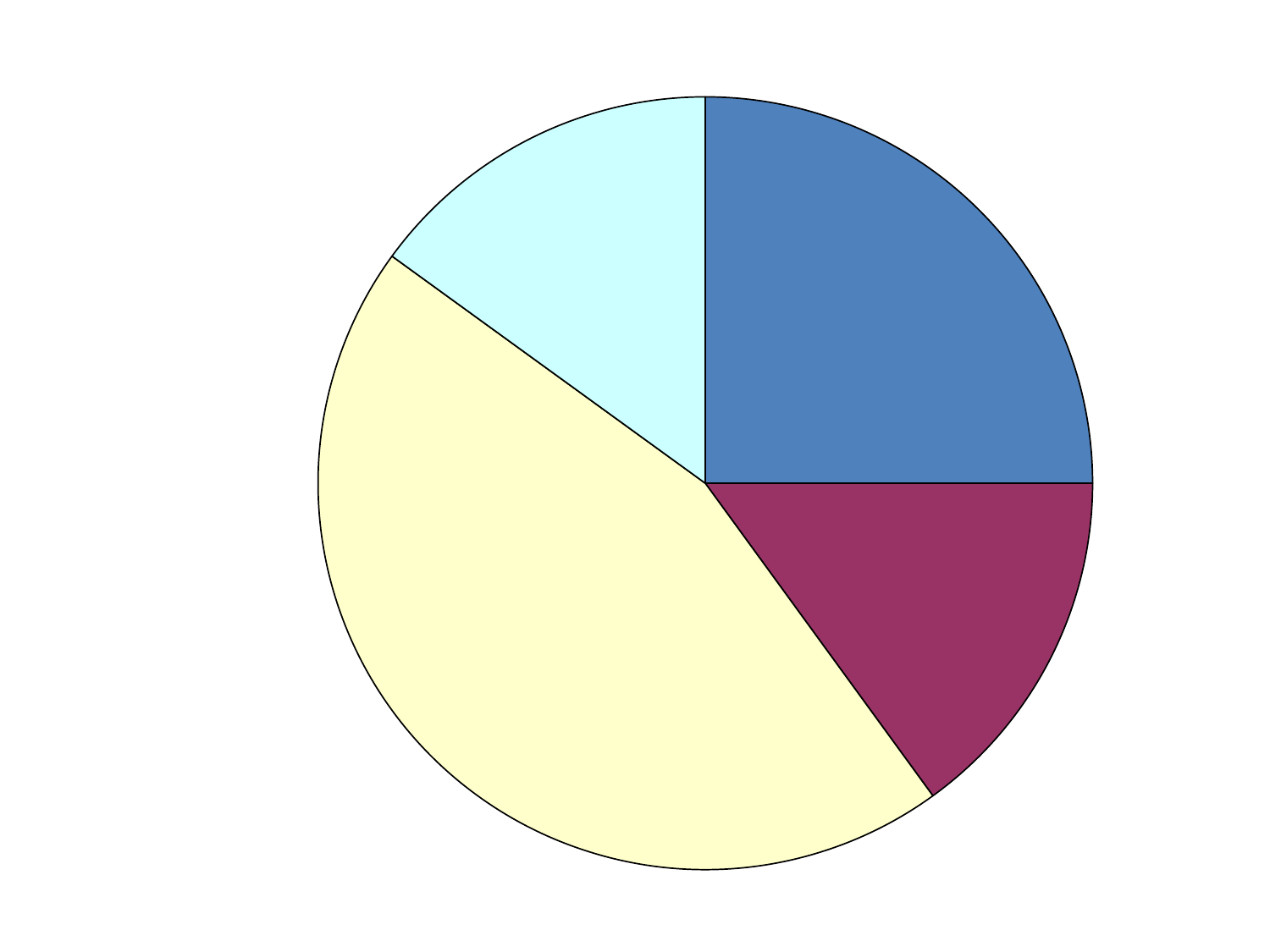
Which is larger in the pie chart, the pale yellow slice or the blue slice? the pale yellow slice Which is larger in the pie chart, the blue slice or the light cyan slice? the blue slice Does the pie chart show a title? no What kind of chart is shown on the slide? pie chart Which is larger in the pie chart, the pale yellow slice or the maroon slice? the pale yellow slice Does the pie chart have a legend? no How many slices does the pie chart have? 4 Which slice of the pie chart is the largest? the pale yellow slice